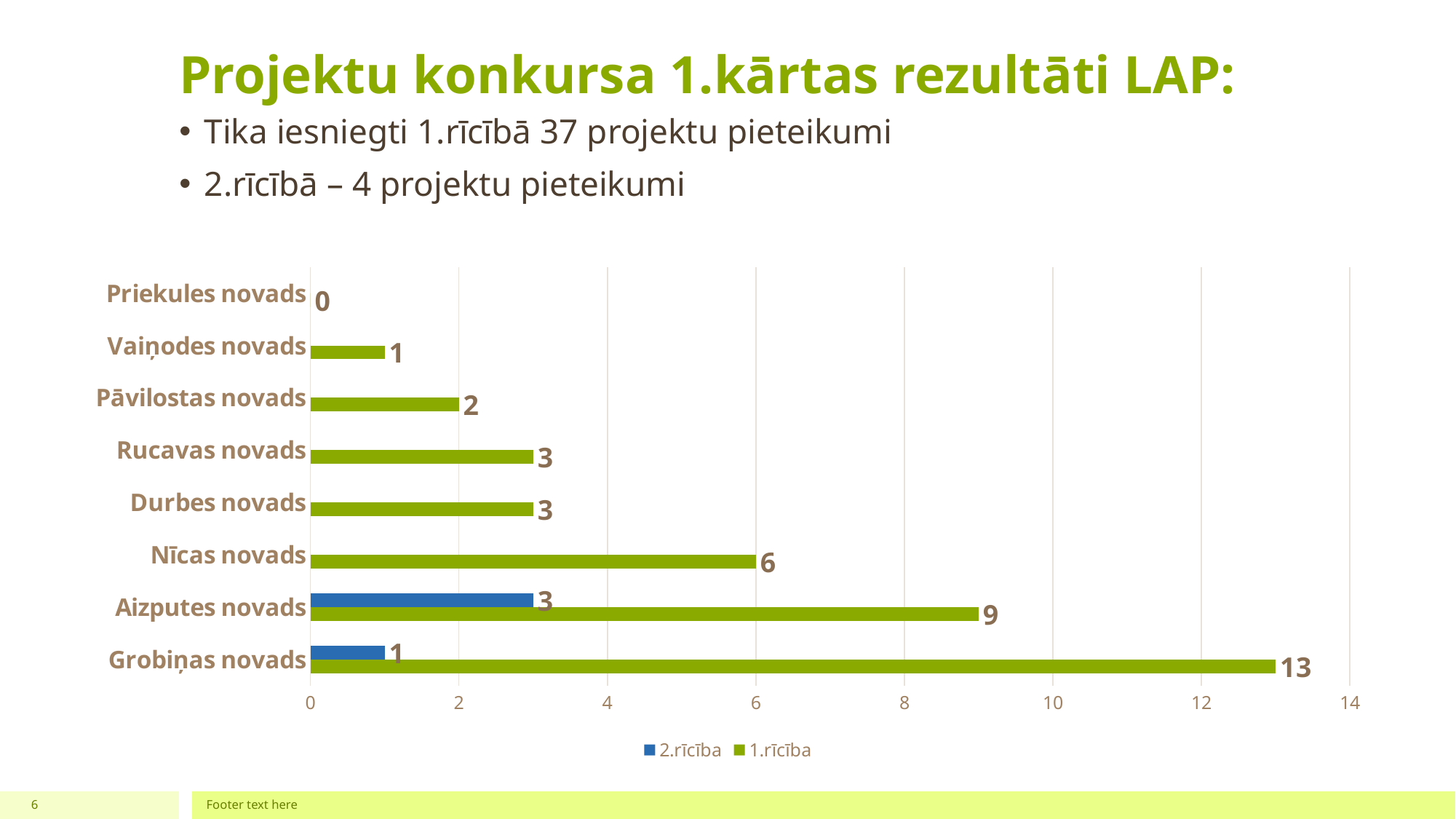
How many series does the legend list? 2 What kind of chart is shown on the slide? bar chart What is the total of the 1.rīcība and 2.rīcība values for Grobiņas novads? 14 Which category has the lowest 1.rīcība value? Priekules novads What is the 2.rīcība value for Aizputes novads? 3 Which category has the highest 1.rīcība value? Grobiņas novads What is the 1.rīcība value for Grobiņas novads? 13 Which colour represents the 2.rīcība series in the legend? blue What is the 1.rīcība value for Nīcas novads? 6 How many categories (novads) are shown on the chart? 8 Which is larger: the 1.rīcība value for Nīcas novads or for Durbes novads? Nīcas novads What is the difference between the 1.rīcība values for Grobiņas novads and Aizputes novads? 4